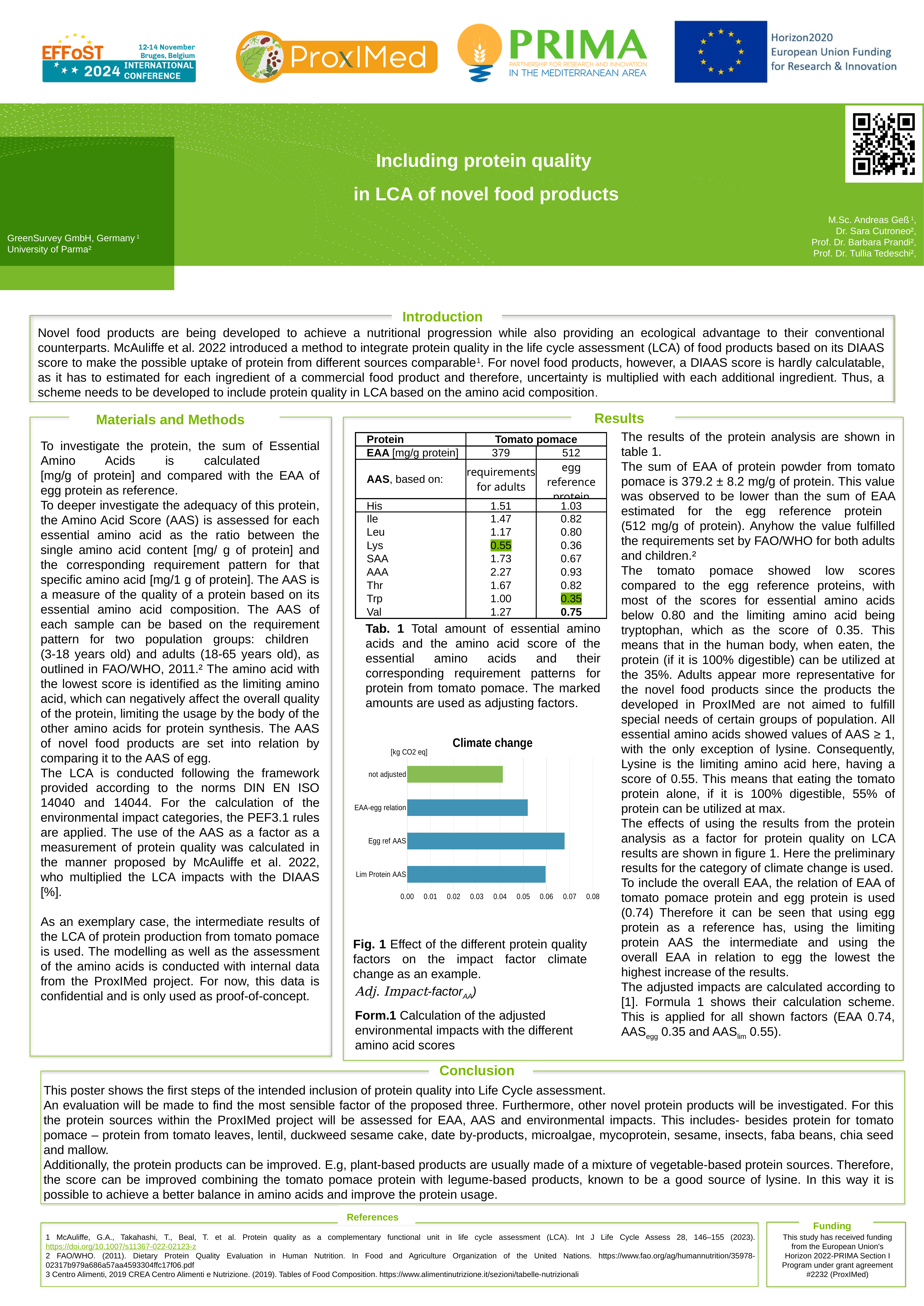
What is the title of the bar chart on the slide? Climate change How many categories are shown in the "Climate change" chart? 4 In the "Climate change" chart, is the value for "not adjusted" greater or less than 0.05? less What kind of chart is the "Climate change" chart? bar chart Which category has the lowest value in the "Climate change" chart? not adjusted In the "Climate change" chart, which is larger: "Egg ref AAS" or "Lim Protein AAS"? Egg ref AAS In the "Climate change" chart, is the value for "EAA-egg relation" greater or less than 0.06? less In the "Climate change" chart, is the value for "Lim Protein AAS" greater or less than 0.05? greater In the "Climate change" chart, which is larger: "not adjusted" or "EAA-egg relation"? EAA-egg relation Which category has the highest value in the "Climate change" chart? Egg ref AAS What unit is shown on the "Climate change" chart? [kg CO2 eq]